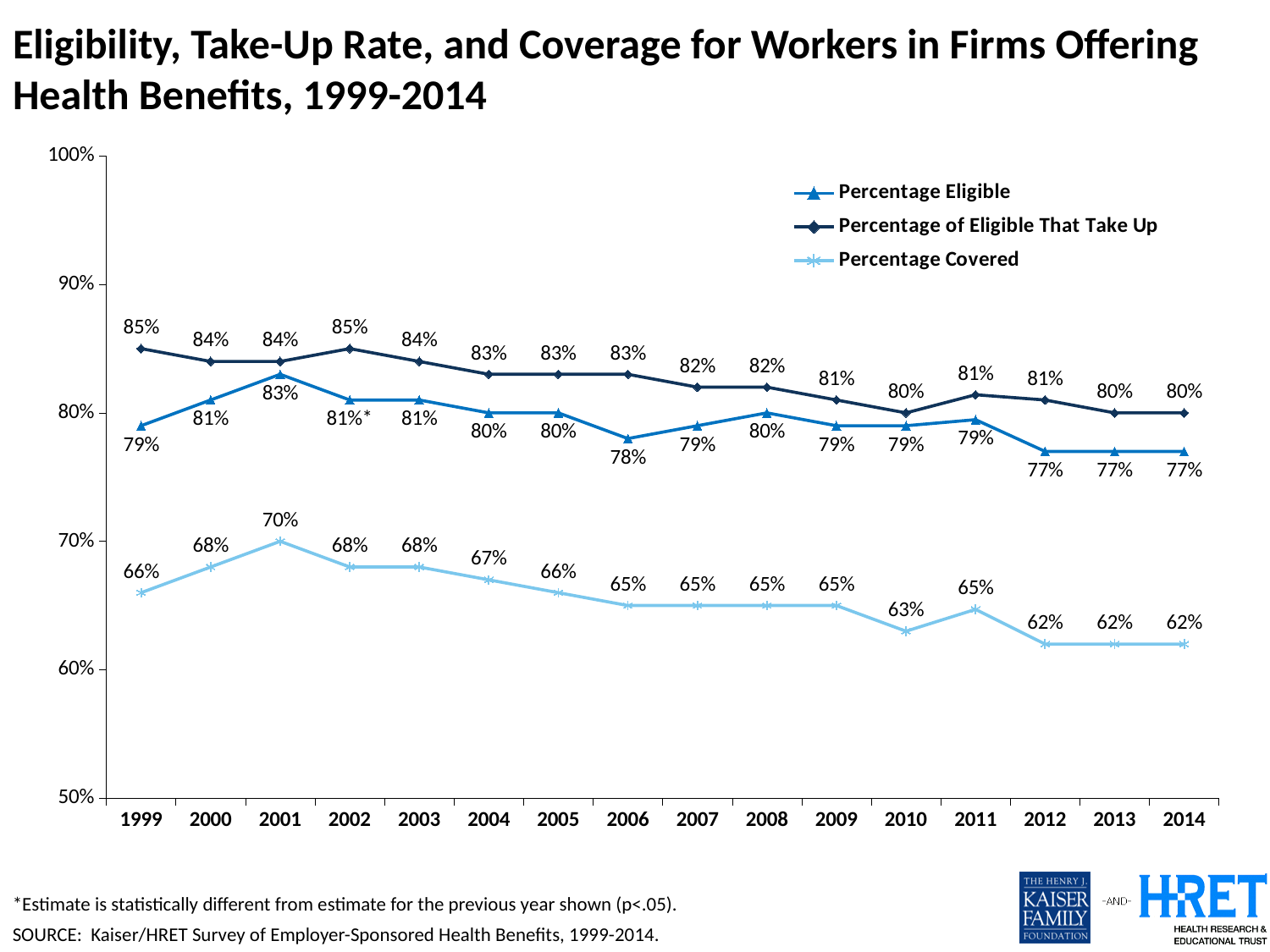
What is the Percentage of Eligible That Take Up value for 1999? 85% Does the Percentage of Eligible That Take Up series rise or fall from 1999 to 2014? Fall What is the difference between Percentage of Eligible That Take Up and Percentage Eligible in 1999? 6 percentage points What is the Percentage Covered value for 2001? 70% What kind of chart is shown on the slide? Line chart How many years are shown on the x axis? 16 What is the Percentage Eligible value for 2006? 78% Which data point is marked with an asterisk indicating a statistically significant change from the previous year? Percentage Eligible in 2002 (81%) Which year has the higher Percentage Covered value, 2010 or 2011? 2011 In which year is the Percentage Eligible series at its highest? 2001 How many series does the legend list? 3 In which year is the Percentage Covered series at its highest? 2001